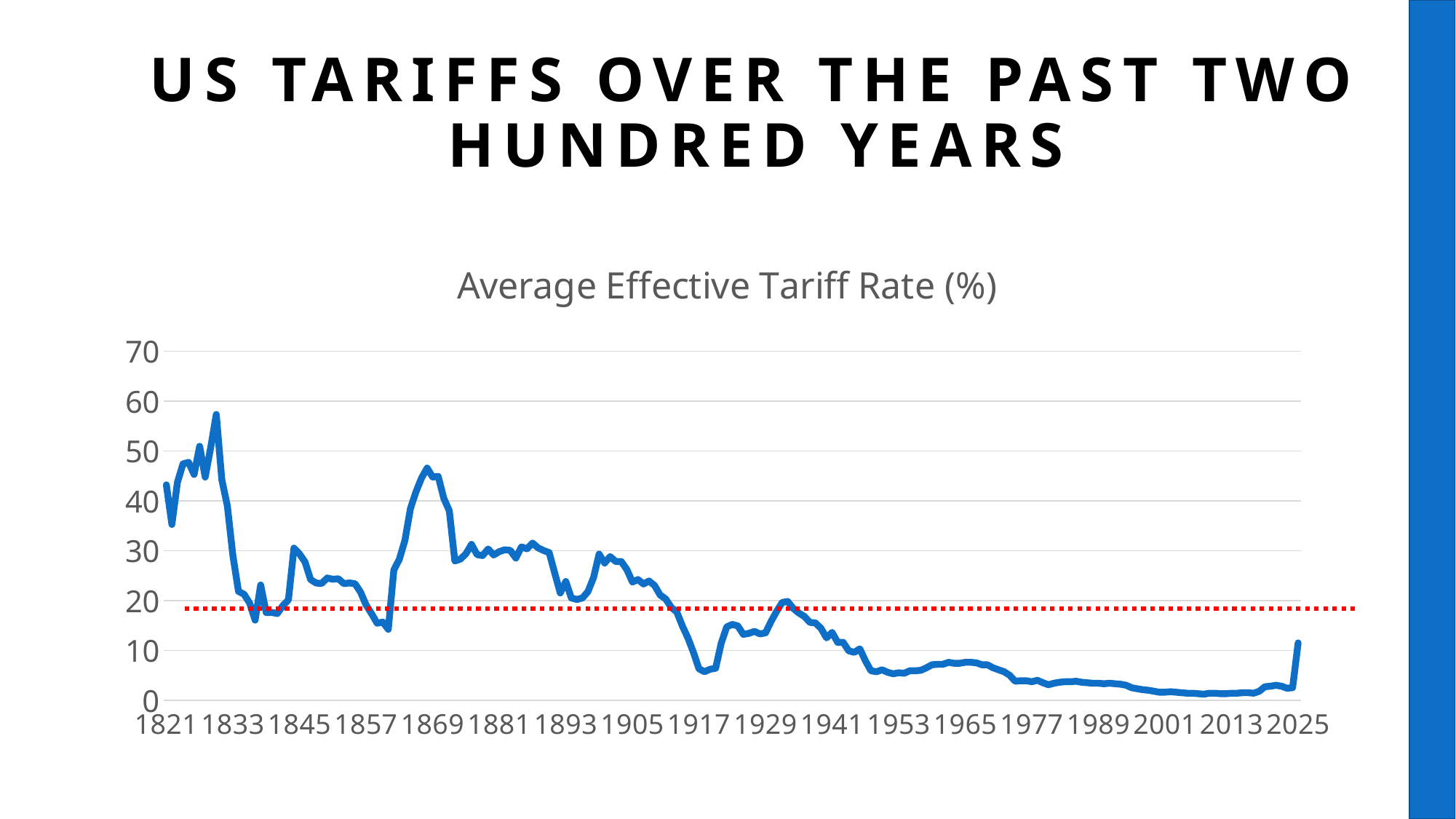
What is the highest value shown on the vertical axis? 70 What kind of chart is shown on the slide? line chart What is the title of the chart? Average Effective Tariff Rate (%) Is the value for 1917 greater or less than 20? less Is the level of the red dotted horizontal line greater or less than 20? less Is the value for 1869 greater or less than 30? greater Overall, does the tariff rate rise or fall from 1821 to 2013? fall Which year has the larger tariff rate, 1869 or 1929? 1869